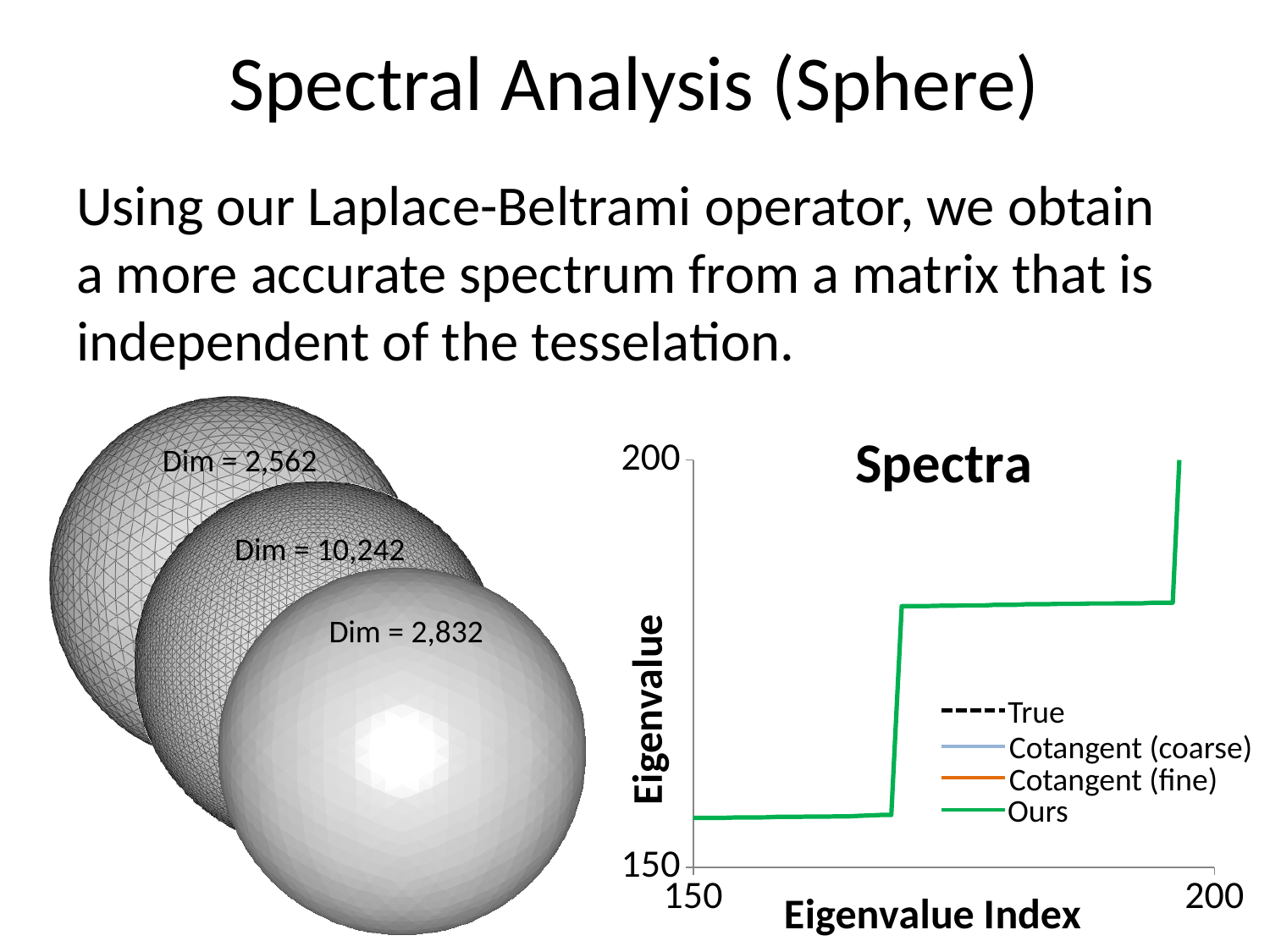
Which series in the legend is drawn with a dashed line? True Do the plotted eigenvalues rise or fall as the eigenvalue index increases? rise What is the title of the chart? Spectra What is the lowest eigenvalue index shown on the x axis of the chart? 150 Is the plotted eigenvalue at eigenvalue index 150 greater or less than 200? less What type of chart is shown on the slide? line chart Is the plotted eigenvalue at eigenvalue index 150 greater or less than 150? greater How many series does the chart's legend list? 4